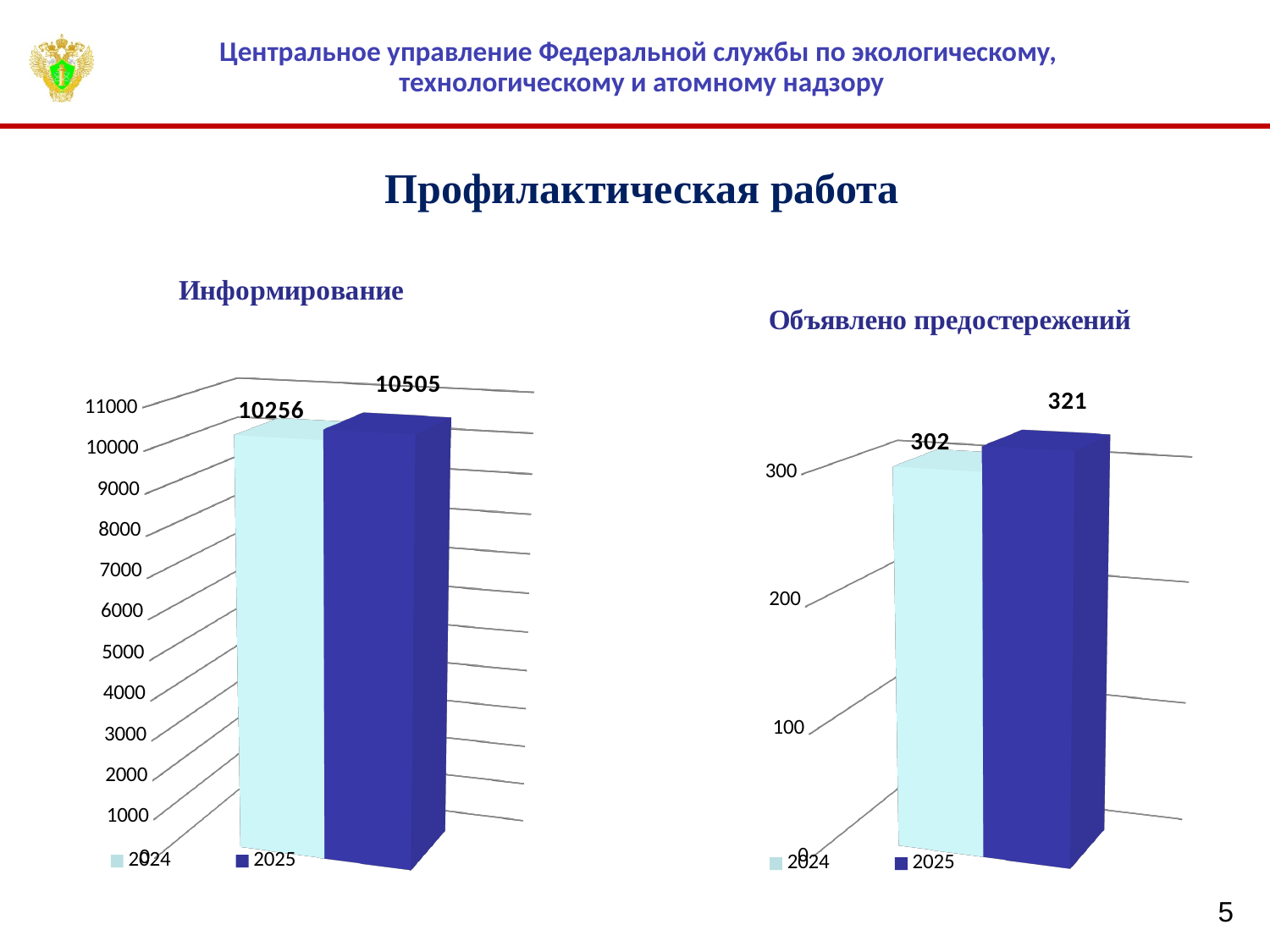
What kind of chart is the "Объявлено предостережений" chart? bar chart In the "Объявлено предостережений" chart, what is the value for 2025? 321 How many series does the legend of the "Информирование" chart list? 2 In the "Информирование" chart, what is the difference between the 2025 and 2024 values? 249 In the "Объявлено предостережений" chart, what is the value for 2024? 302 In the "Информирование" chart, what is the value for 2024? 10256 In the "Объявлено предостережений" chart, which year has the lower value? 2024 In the "Информирование" chart, which colour represents 2025? dark blue In the "Информирование" chart, what is the value for 2025? 10505 In the "Информирование" chart, which year has the higher value? 2025 In the "Объявлено предостережений" chart, is the value for 2024 greater or less than 300? greater In the "Объявлено предостережений" chart, what is the difference between the 2025 and 2024 values? 19